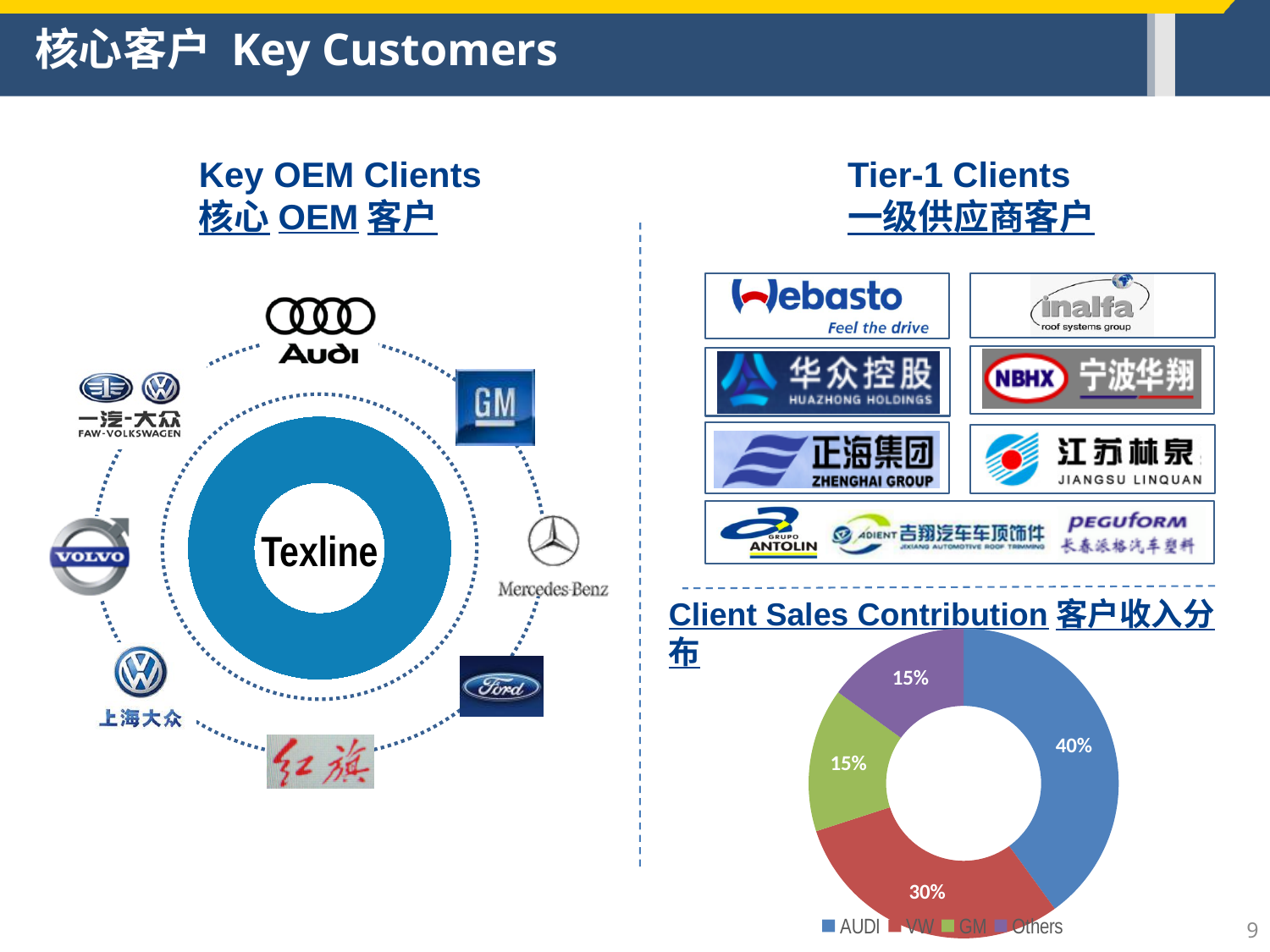
In the Client Sales Contribution chart, what is the combined share of AUDI and VW? 70% In the Client Sales Contribution chart, what is the difference in percentage points between AUDI's share and VW's share? 10 percentage points In the Client Sales Contribution chart, which colour represents AUDI? Blue How many clients or categories does the legend of the Client Sales Contribution chart list? 4 In the Client Sales Contribution chart, what share of sales comes from VW? 30% In the Client Sales Contribution chart, what share of sales comes from AUDI? 40% What kind of chart is the Client Sales Contribution chart? Doughnut (pie) chart In the Client Sales Contribution chart, which client has the largest share of sales? AUDI In the Client Sales Contribution chart, which is larger, the share for VW or the share for GM? VW In the Client Sales Contribution chart, what share of sales comes from GM? 15% In the Client Sales Contribution chart, what share of sales is attributed to Others? 15% In the Client Sales Contribution chart, what is the difference in percentage points between VW's share and GM's share? 15 percentage points